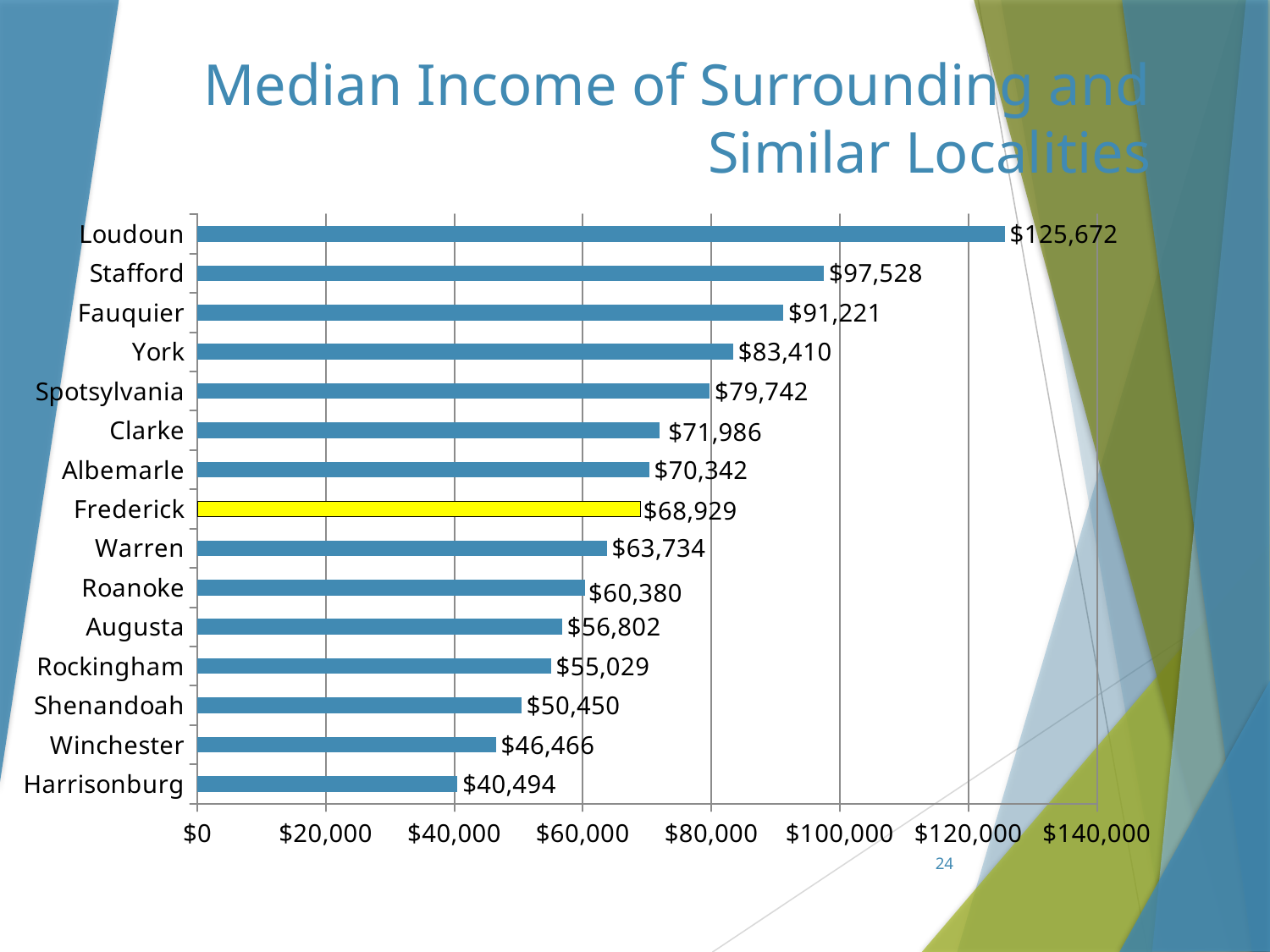
What is the difference between the median incomes of Loudoun and Harrisonburg? $85,178 What is the median income for Stafford? $97,528 Which locality's bar is highlighted in yellow? Frederick What is the difference between the median incomes of Albemarle and Frederick? $1,413 Which has a higher median income, York or Spotsylvania? York What kind of chart is shown on the slide? Bar chart Which locality has the highest median income? Loudoun What is the median income for Shenandoah? $50,450 What is the median income for Frederick? $68,929 Is the median income for Winchester greater or less than $40,000? greater How many localities are shown in the chart? 15 Which locality has the lowest median income? Harrisonburg